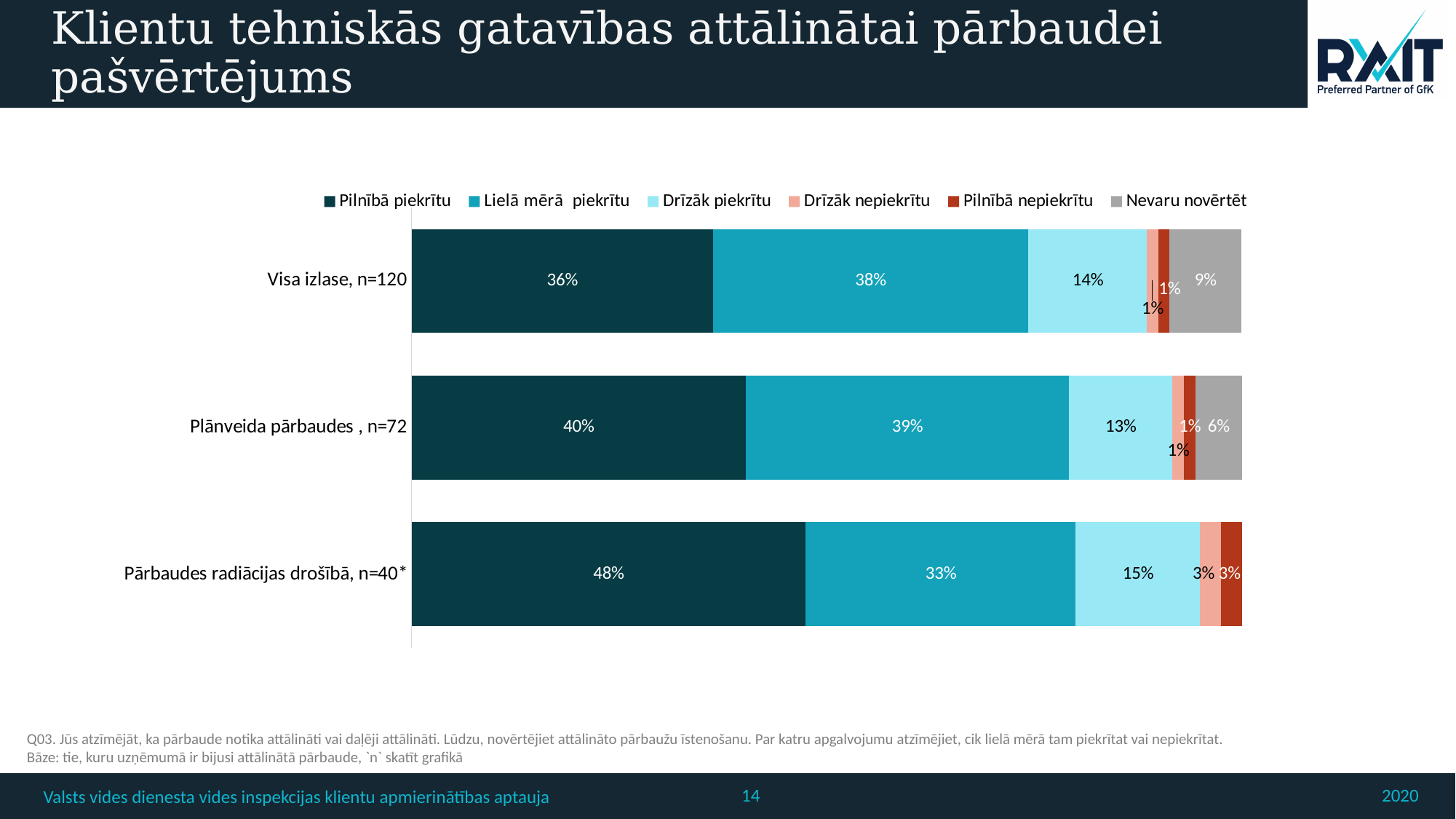
What is the difference between the "Pilnībā piekrītu" values for "Pārbaudes radiācijas drošībā, n=40*" and "Visa izlase, n=120"? 12% What kind of chart is shown on the slide? Stacked bar chart Which is larger: "Nevaru novērtēt" for "Visa izlase, n=120" or for "Plānveida pārbaudes , n=72"? Visa izlase, n=120 What is the value of "Nevaru novērtēt" for "Visa izlase, n=120"? 9% What is the value of "Drīzāk piekrītu" for "Pārbaudes radiācijas drošībā, n=40*"? 15% Which category has the highest value for "Pilnībā piekrītu"? Pārbaudes radiācijas drošībā, n=40* How many series does the legend list? 6 How many categories (bars) are shown in the chart? 3 What is the value of "Pilnībā piekrītu" for "Visa izlase, n=120"? 36% What is the value of "Lielā mērā piekrītu" for "Plānveida pārbaudes , n=72"? 39% What is the combined value of "Pilnībā piekrītu" and "Lielā mērā piekrītu" for "Plānveida pārbaudes , n=72"? 79% Which category has the lowest value for "Lielā mērā piekrītu"? Pārbaudes radiācijas drošībā, n=40*